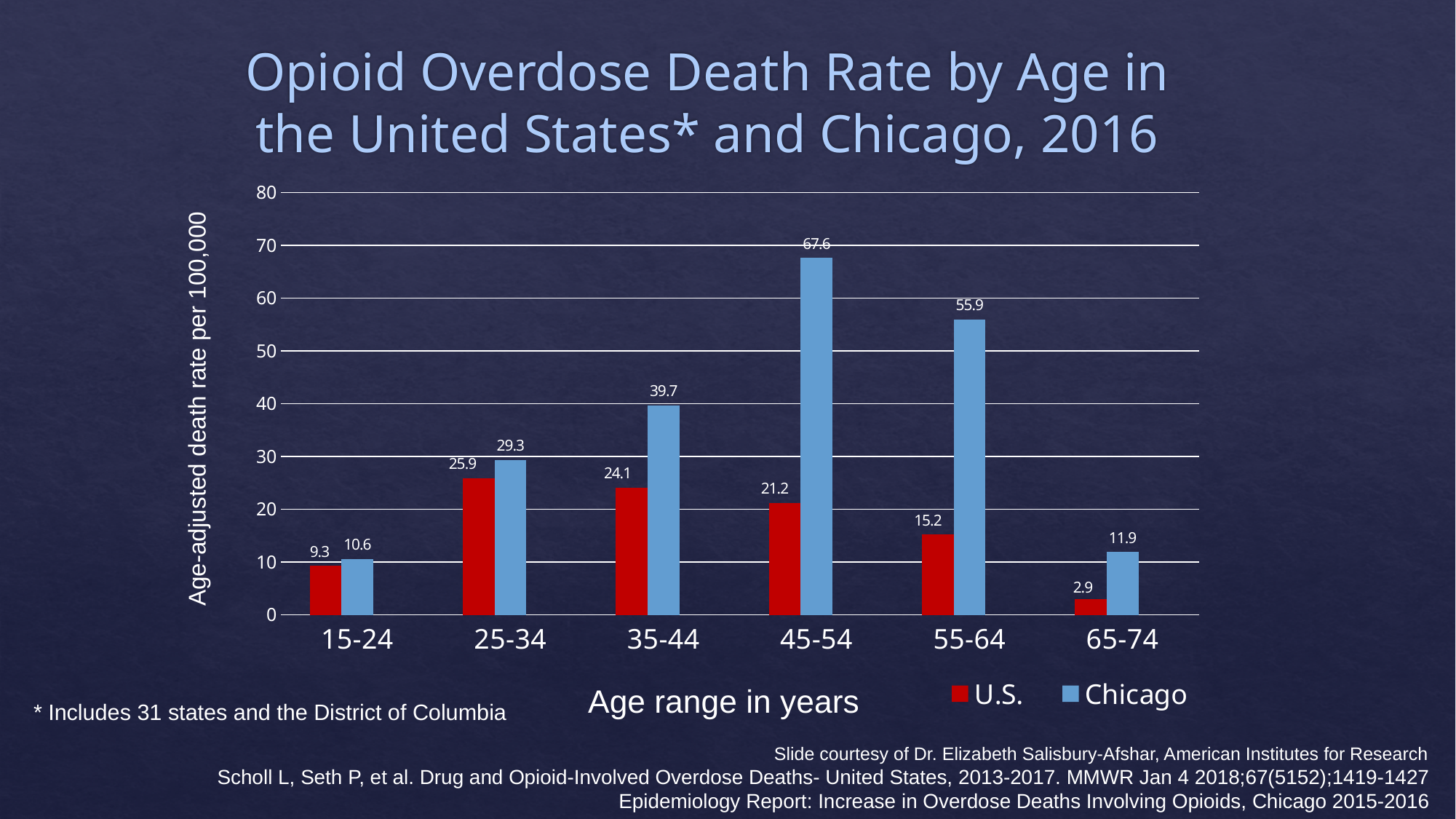
Is the Chicago death rate for the 35-44 age range greater or less than 30? greater How many series does the legend list? 2 What is the Chicago opioid overdose death rate for the 45-54 age range? 67.6 What is the label of the y axis? Age-adjusted death rate per 100,000 Which age range has the lowest U.S. death rate? 65-74 What is the difference between the Chicago and U.S. death rates for the 55-64 age range? 40.7 Which age range has the highest Chicago death rate? 45-54 What kind of chart is shown on the slide? Bar chart How many age ranges are shown on the x axis? 6 Which is larger, the U.S. death rate for 35-44 or the U.S. death rate for 45-54? U.S. death rate for 35-44 What is the U.S. death rate for the 65-74 age range? 2.9 What is the U.S. opioid overdose death rate for the 25-34 age range? 25.9